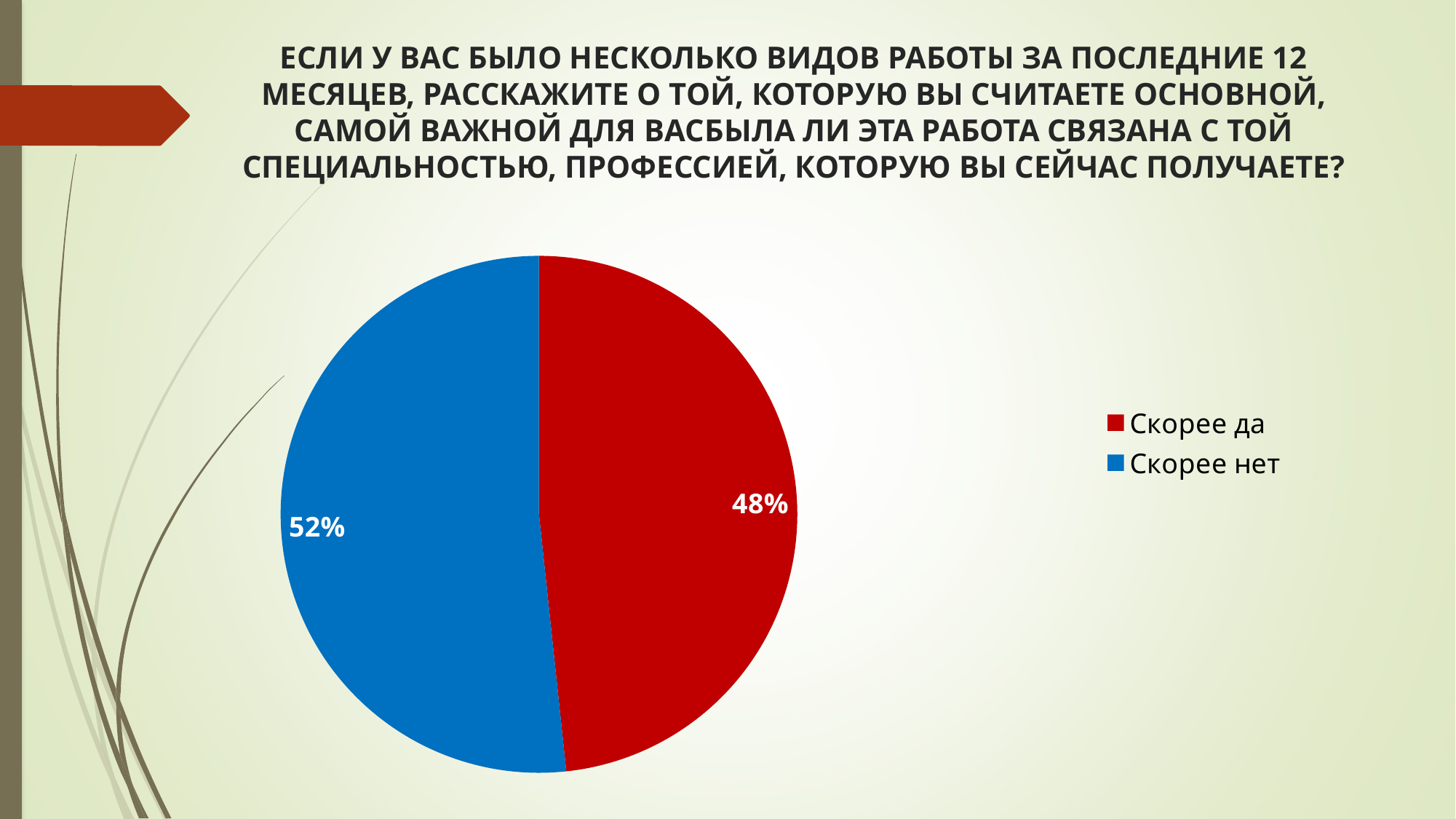
What colour is the "Скорее да" slice? Red What share of the pie is labelled "Скорее нет"? 52% Which slice is the largest? Скорее нет What share of the pie is labelled "Скорее да"? 48% Which slice is the smallest? Скорее да What kind of chart is shown on the slide? Pie chart How many slices does the pie chart have? 2 What is the difference in percentage points between "Скорее нет" and "Скорее да"? 4 Which is larger, "Скорее да" or "Скорее нет"? Скорее нет Is the share for "Скорее да" greater or less than 50%? less How many entries does the legend list? 2 What colour is the "Скорее нет" slice? Blue